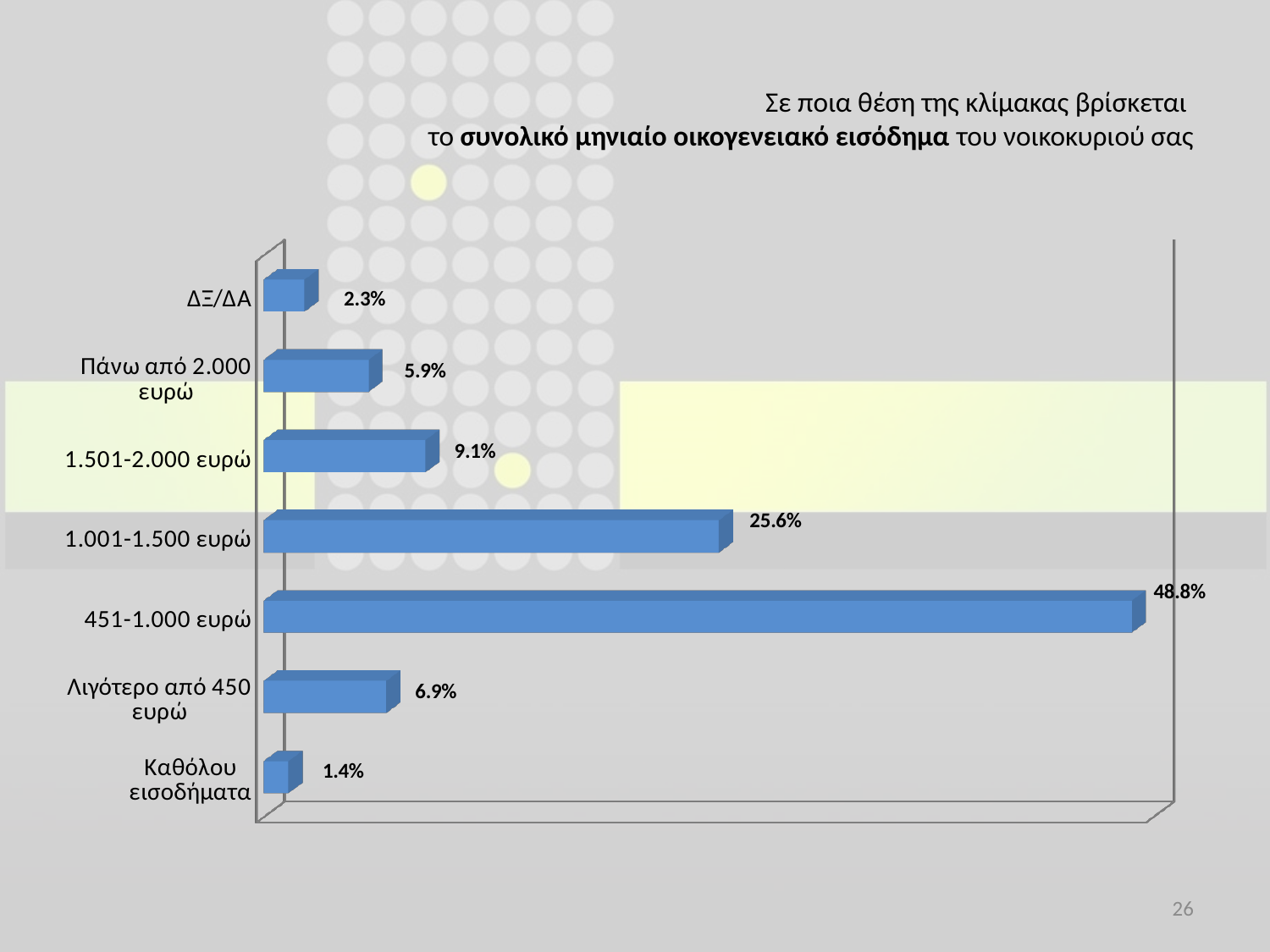
Which category has the lowest value? Καθόλου εισοδήματα What is the difference between the values for 1.501-2.000 ευρώ and Λιγότερο από 450 ευρώ? 2.2% What kind of chart is shown on the slide? Bar chart What is the value for the category 451-1.000 ευρώ? 48.8% What is the difference between the values for 451-1.000 ευρώ and 1.001-1.500 ευρώ? 23.2% What is the value for the category Πάνω από 2.000 ευρώ? 5.9% What is the value for the category ΔΞ/ΔΑ? 2.3% What is the value for the category 1.001-1.500 ευρώ? 25.6% Which category has the highest value? 451-1.000 ευρώ How many categories are shown in the chart? 7 What is the value for the category Καθόλου εισοδήματα? 1.4% Which is larger, the value for Λιγότερο από 450 ευρώ or the value for Πάνω από 2.000 ευρώ? Λιγότερο από 450 ευρώ